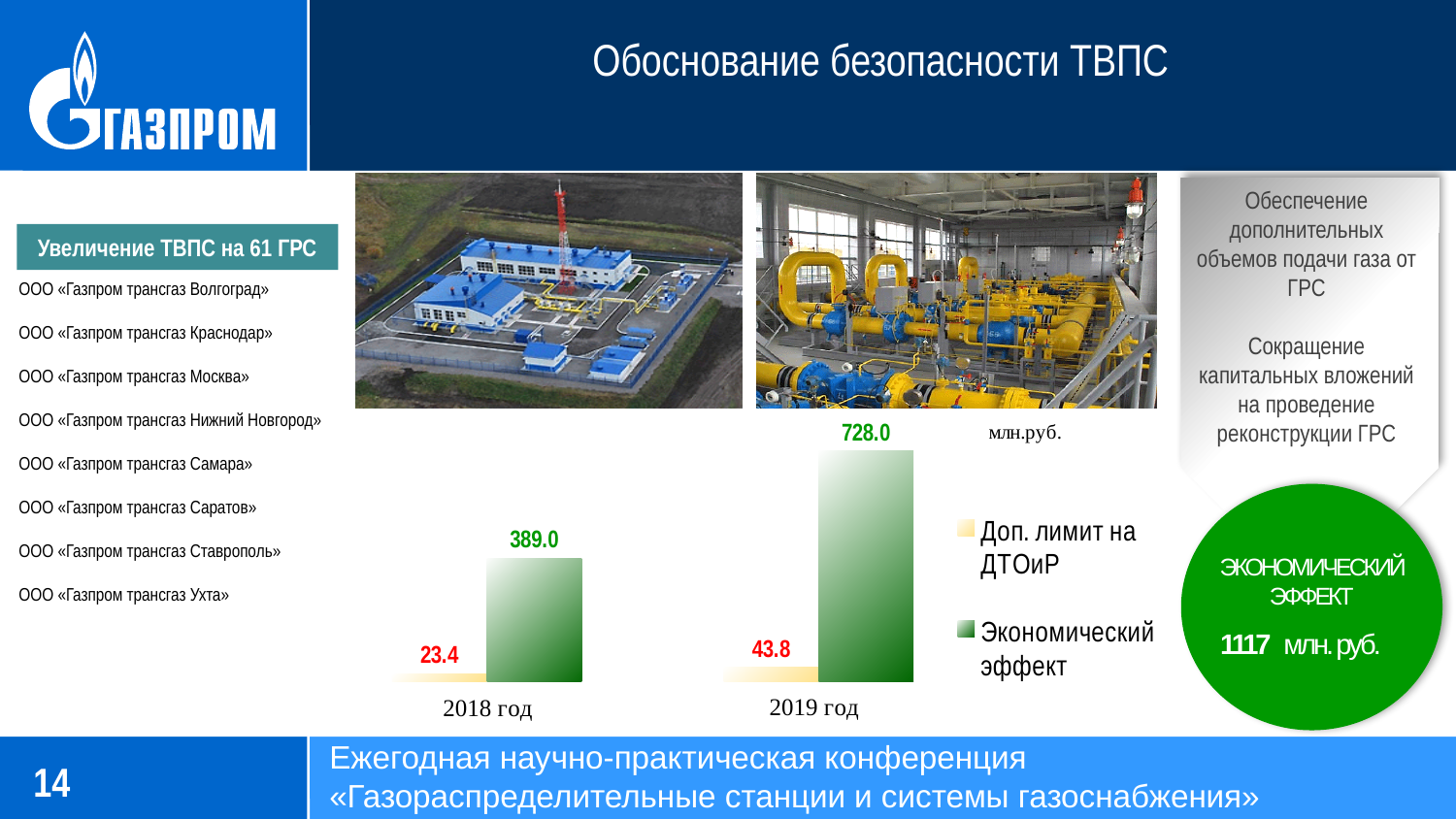
Which year has the higher Экономический эффект? 2019 год How many years (categories) are shown on the chart? 2 What is the value of Экономический эффект for 2019 год? 728.0 What is the value of Доп. лимит на ДТОиР for 2018 год? 23.4 What type of chart is shown on the slide? bar chart What is the value of Экономический эффект for 2018 год? 389.0 How many series does the chart legend list? 2 Which year has the lower Доп. лимит на ДТОиР? 2018 год Is the Экономический эффект for 2018 год larger or smaller than for 2019 год? smaller What is the value of Доп. лимит на ДТОиР for 2019 год? 43.8 What is the difference in Экономический эффект between 2019 год and 2018 год? 339.0 What is the difference in Доп. лимит на ДТОиР between 2019 год and 2018 год? 20.4